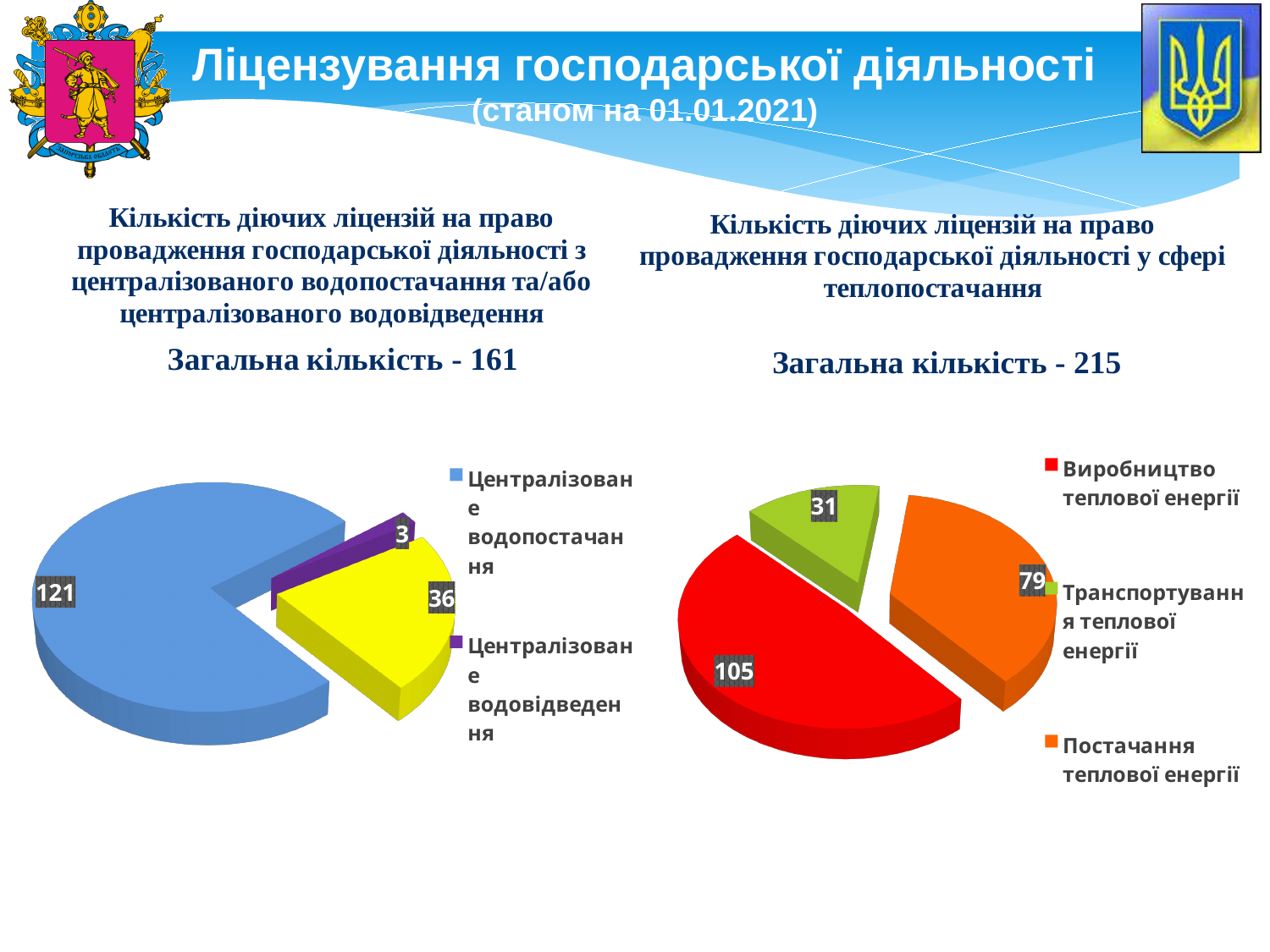
In the right pie chart, which is larger: Постачання теплової енергії or Транспортування теплової енергії? Постачання теплової енергії In the left pie chart, what is the value for Централізоване водовідведення? 3 In the right pie chart, what is the difference between Виробництво теплової енергії and Постачання теплової енергії? 26 What type of chart is used on the left side of the slide? pie chart In the left pie chart, which category has the largest slice? Централізоване водопостачання In the right pie chart (heat supply), what is the value for Виробництво теплової енергії? 105 In the left pie chart, what is the difference between the values 121 and 36? 85 How many entries does the legend of the left pie chart list? 2 How many slices does the left pie chart have? 3 In the right pie chart, which category has the smallest value? Транспортування теплової енергії In the left pie chart (centralized water supply and drainage), what is the value for Централізоване водопостачання? 121 In the right pie chart, what is the value for Транспортування теплової енергії? 31